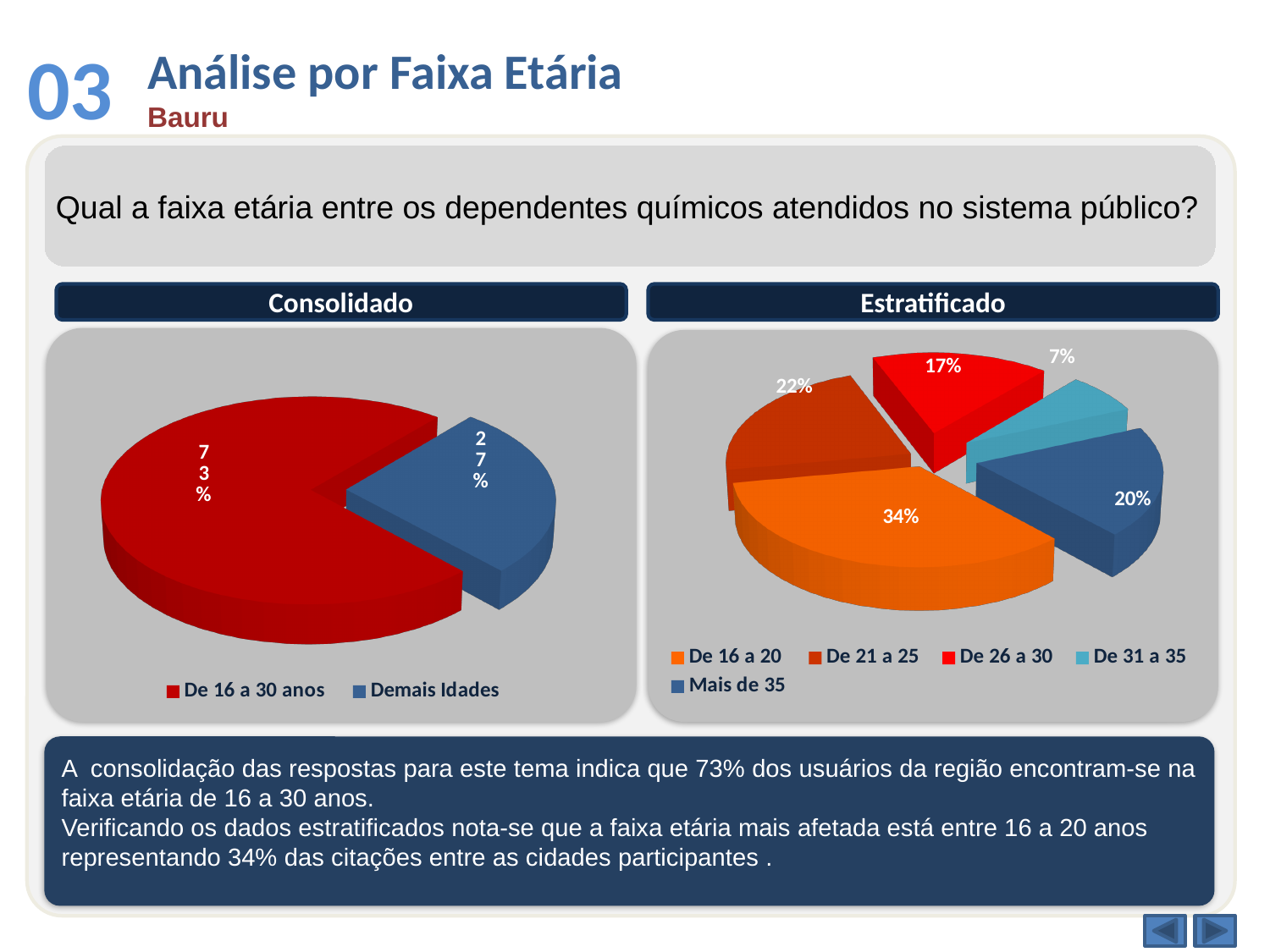
In the Consolidado chart, what share is labelled for Demais Idades? 27% What type of chart is the Consolidado chart? Pie chart How many slices does the Estratificado chart have? 5 In the Estratificado chart, what share is labelled for Mais de 35? 20% In the Estratificado chart, what share is labelled for De 31 a 35? 7% In the Estratificado chart, which age group has the smallest slice? De 31 a 35 In the Estratificado chart, which age group has the largest slice? De 16 a 20 In the Estratificado chart, which is larger: De 21 a 25 or Mais de 35? De 21 a 25 In the Consolidado chart, what share is labelled for De 16 a 30 anos? 73% In the Estratificado chart, what is the difference in percentage points between De 21 a 25 and De 26 a 30? 5 In the Estratificado chart, what share is labelled for De 16 a 20? 34% How many entries does the legend of the Consolidado chart list? 2